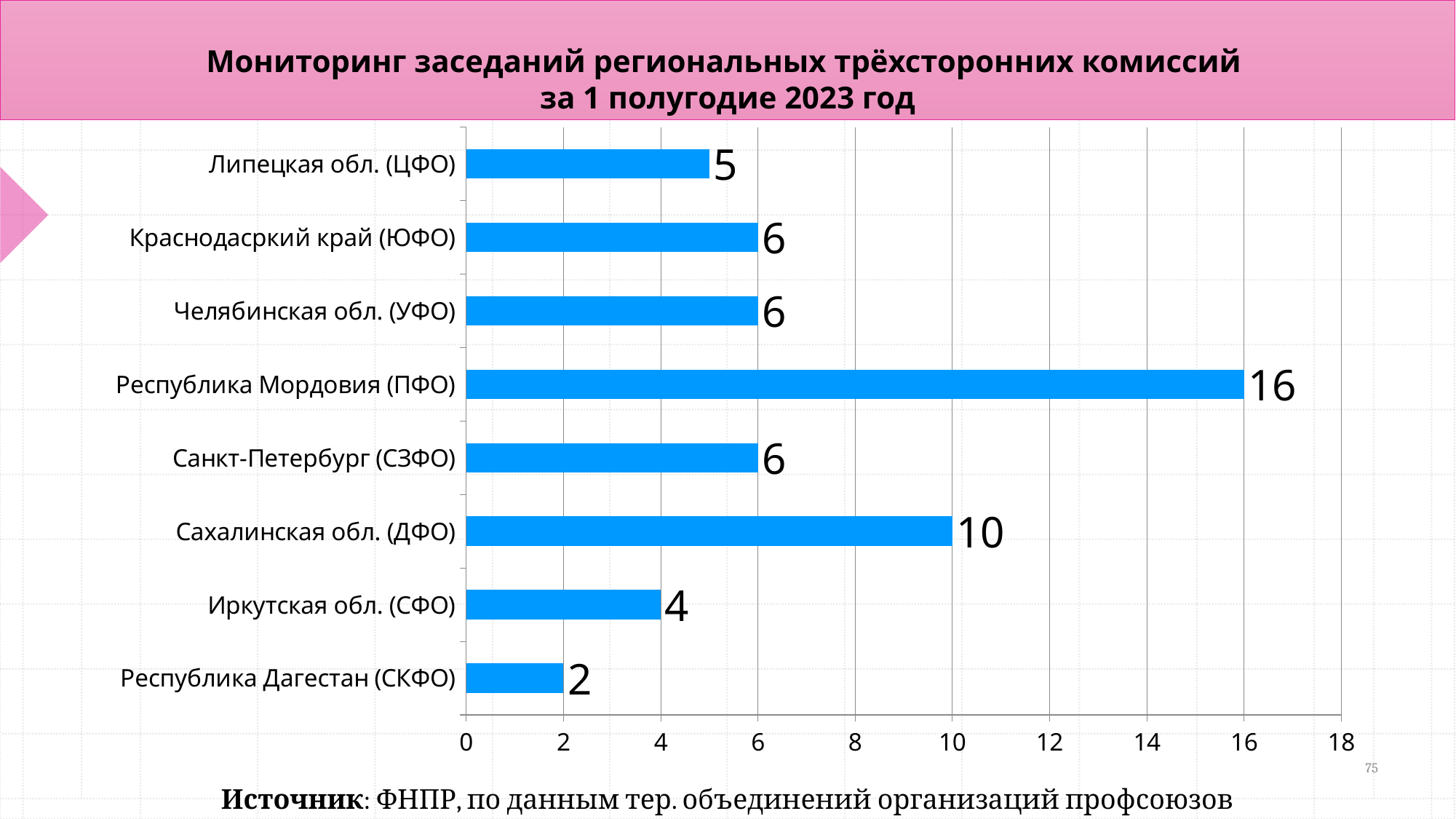
Which is larger, the value for Иркутская обл. (СФО) or the value for Липецкая обл. (ЦФО)? Липецкая обл. (ЦФО) How many regions are shown in the chart? 8 What is the value for Республика Мордовия (ПФО)? 16 What is the value for Республика Дагестан (СКФО)? 2 What is the title of the chart? Мониторинг заседаний региональных трёхсторонних комиссий за 1 полугодие 2023 год Which region has the lowest value? Республика Дагестан (СКФО) What is the value for Липецкая обл. (ЦФО)? 5 What kind of chart is shown on the slide? bar chart Which region has the highest value? Республика Мордовия (ПФО) Is the value for Сахалинская обл. (ДФО) greater or less than 8? greater What is the value for Сахалинская обл. (ДФО)? 10 What is the difference between the values for Республика Мордовия (ПФО) and Сахалинская обл. (ДФО)? 6